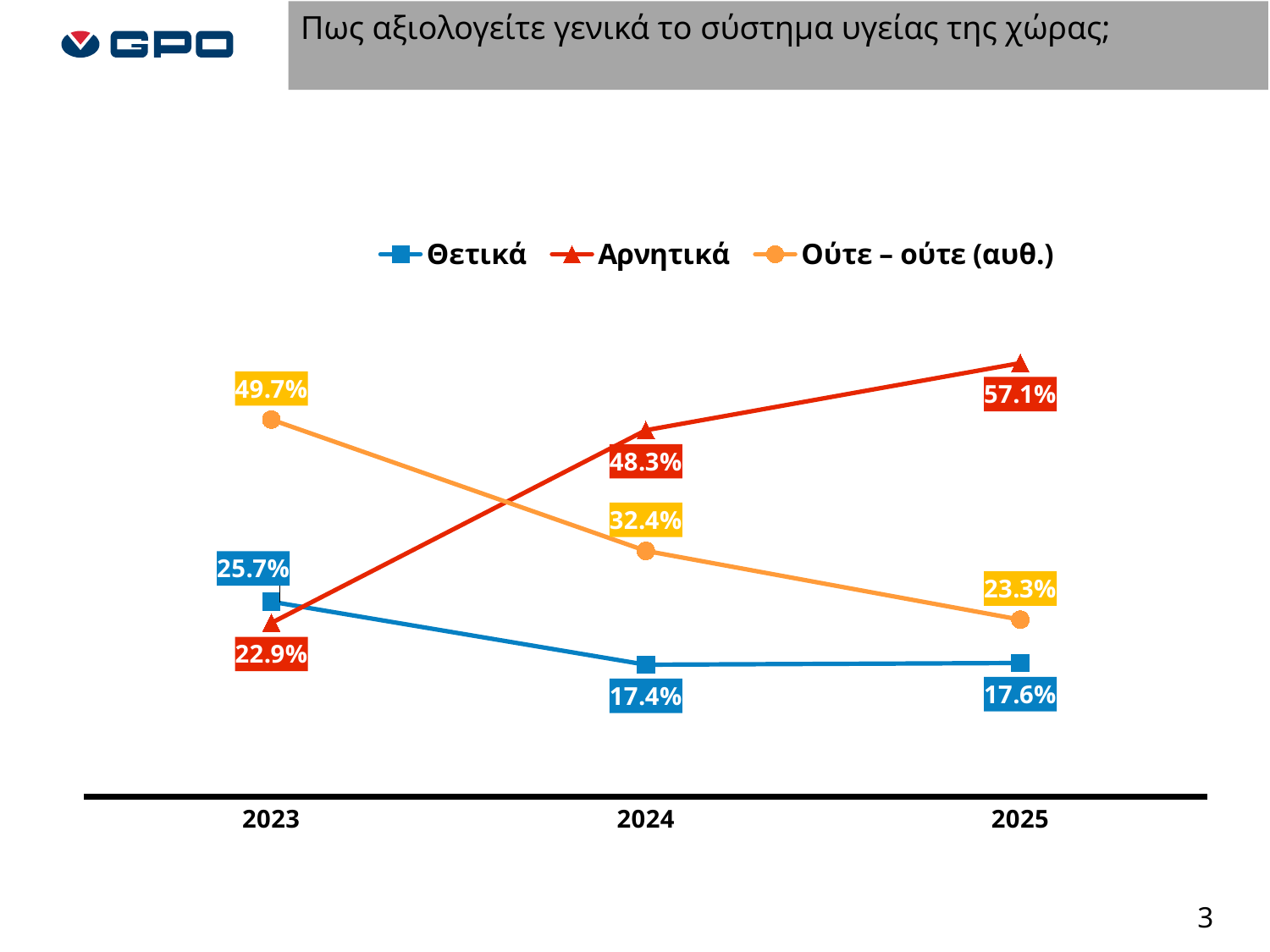
Does the Ούτε – ούτε (αυθ.) series rise or fall from 2023 to 2025? Fall What is the value for Ούτε – ούτε (αυθ.) in 2024? 32.4% What kind of chart is shown on the slide? Line chart How many series does the legend list? 3 Which is larger in 2023: Ούτε – ούτε (αυθ.) or Αρνητικά? Ούτε – ούτε (αυθ.) What is the value for Θετικά in 2023? 25.7% In which year is the Αρνητικά series at its highest? 2025 What is the value for Αρνητικά in 2025? 57.1% What is the difference between Αρνητικά and Θετικά in 2025? 39.5% In which year is the Θετικά series at its lowest? 2024 How many years are shown on the x axis? 3 What colour is the line for the Θετικά series? Blue